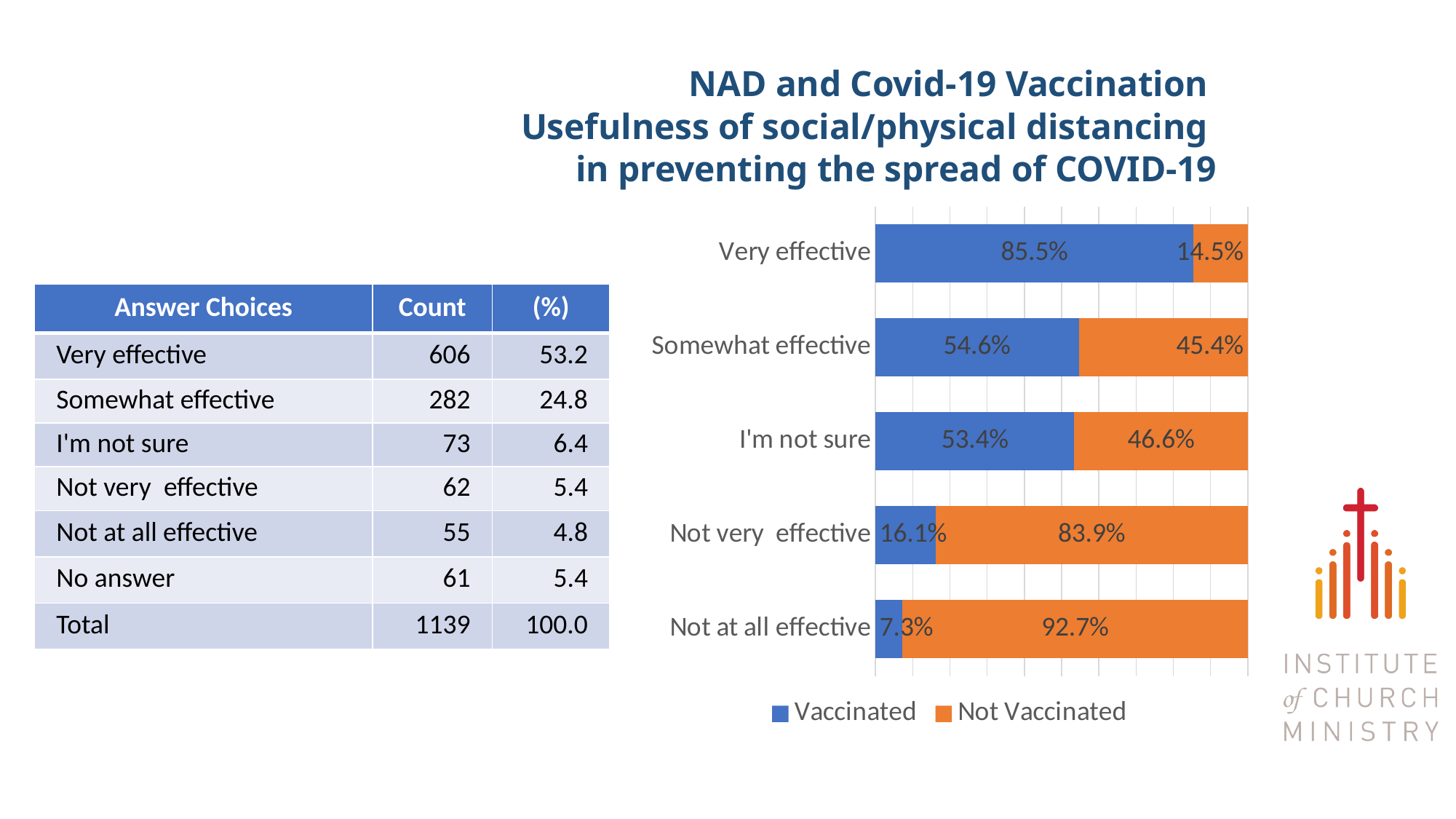
Which category has the lowest Vaccinated share? Not at all effective How many series does the legend list? 2 Which colour represents the Not Vaccinated series? Orange What is the total of the 'I'm not sure' stacked bar? 100% For 'Not very effective', which is larger: Vaccinated or Not Vaccinated? Not Vaccinated What kind of chart is shown on the slide? Stacked bar chart Which category has the highest Vaccinated share? Very effective How many categories are shown in the bar chart? 5 What is the Not Vaccinated value for 'Not at all effective'? 92.7% What percentage of the 'Very effective' bar is Vaccinated? 85.5% What is the difference between the Vaccinated and Not Vaccinated values for 'Somewhat effective'? 9.2 percentage points What is the Vaccinated value for 'I'm not sure'? 53.4%